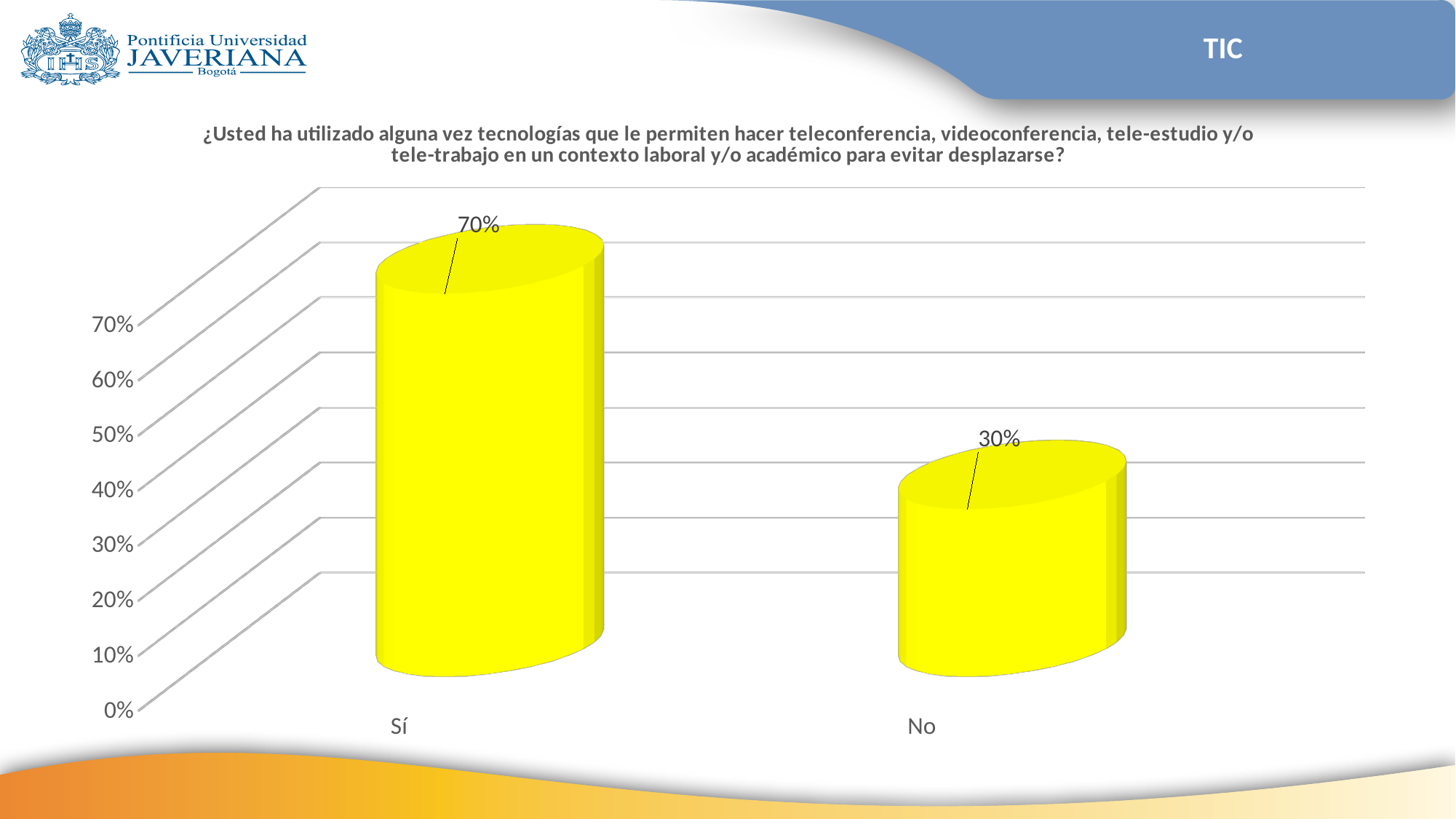
What is the total of the two values shown in the chart? 100% Is the value for "Sí" greater or less than 60%? greater Which is larger, the value for "Sí" or the value for "No"? Sí What kind of chart is shown on the slide? bar chart What colour are the bars in the chart? yellow What is the value for "No"? 30% What is the value for "Sí"? 70% What is the difference between the values for "Sí" and "No"? 40% Which category has the highest value? Sí How many categories are shown on the x axis? 2 Is the value for "No" greater or less than 50%? less Which category has the lowest value? No